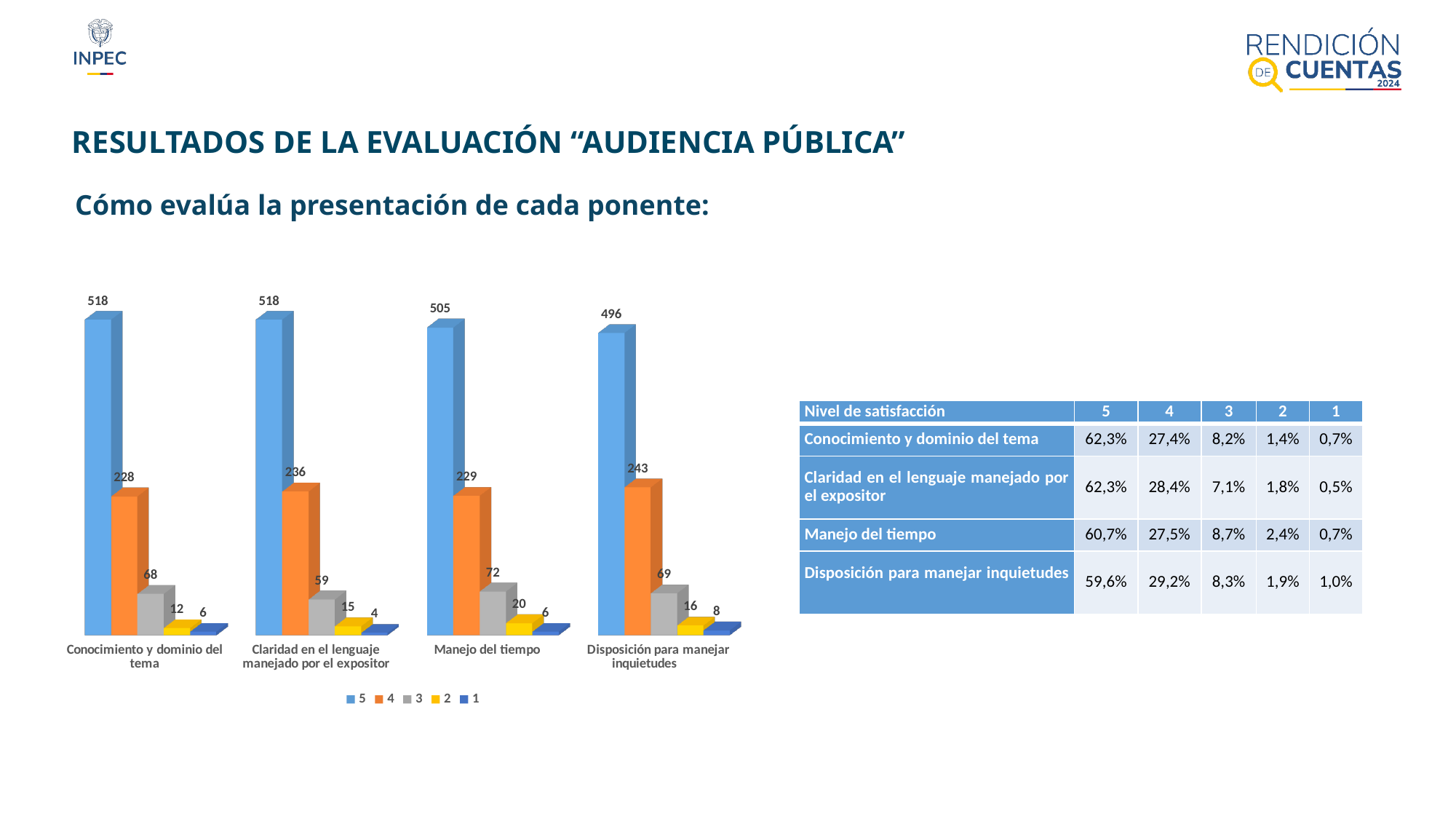
Which category has the highest value for series 3? Manejo del tiempo What kind of chart is shown on the slide? Bar chart Which colour represents series 2 in the chart legend? Yellow How many series does the chart legend list? 5 What is the value for series 1 in the 'Conocimiento y dominio del tema' category? 6 Which is larger: the series 2 value for 'Manejo del tiempo' or the series 2 value for 'Disposición para manejar inquietudes'? Manejo del tiempo What is the value for series 4 in the 'Disposición para manejar inquietudes' category? 243 What is the value for series 3 in the 'Claridad en el lenguaje manejado por el expositor' category? 59 What is the value for series 5 in the 'Manejo del tiempo' category? 505 Which category has the lowest value for series 5? Disposición para manejar inquietudes How many categories are shown on the x axis of the chart? 4 What is the difference between the series 5 value and the series 4 value in the 'Conocimiento y dominio del tema' category? 290